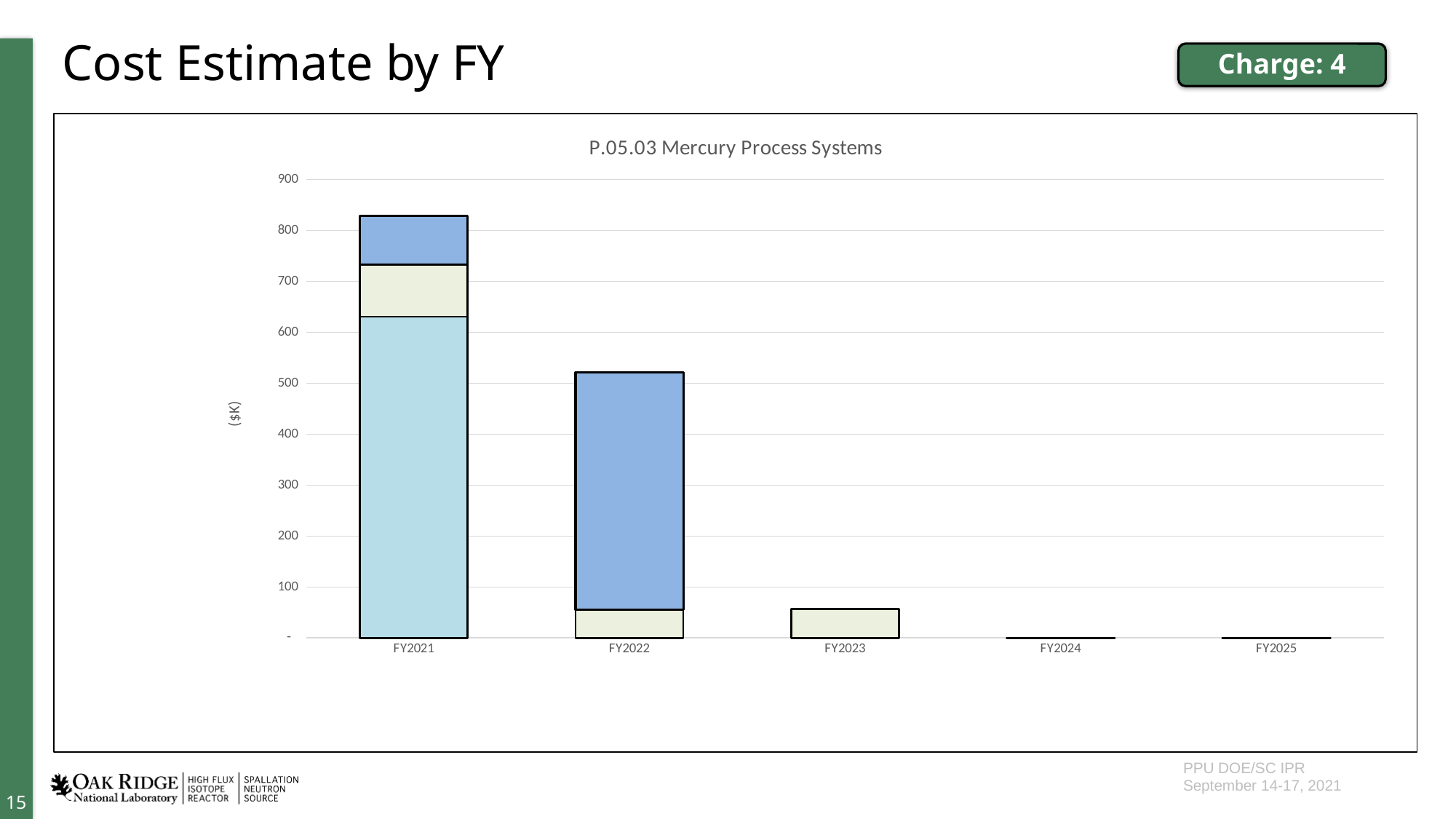
Is the total value for FY2022 greater or less than 400? greater Is the total value for FY2022 greater or less than 600? less Is the value for FY2023 greater or less than 100? less Which is larger, the total for FY2021 or the total for FY2022? FY2021 Which is larger, the total for FY2022 or the total for FY2023? FY2022 How many fiscal years are shown on the x axis of the chart? 5 Which fiscal year has the highest total cost estimate? FY2021 What is the title of the chart? P.05.03 Mercury Process Systems What unit is shown on the y axis of the chart? ($K) What kind of chart is shown on the slide? Stacked bar chart Do the total cost estimates rise or fall from FY2021 to FY2025? Fall